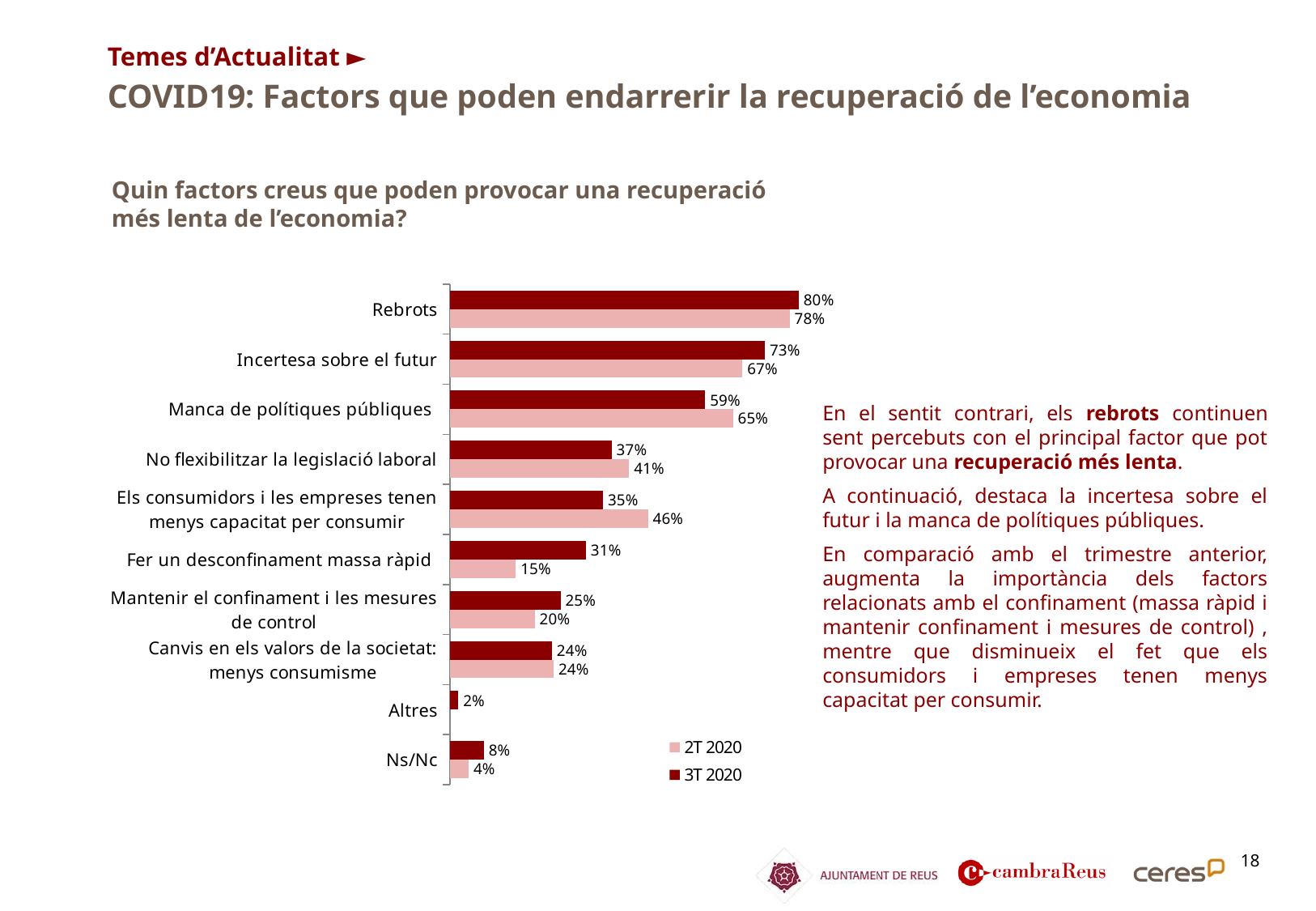
What is the value for Rebrots in the 3T 2020 series? 80% For Manca de polítiques públiques, which series has the larger value, 2T 2020 or 3T 2020? 2T 2020 What is the difference between the 3T 2020 and 2T 2020 values for Els consumidors i les empreses tenen menys capacitat per consumir? 11% What is the value for Ns/Nc in the 3T 2020 series? 8% How many categories are shown on the chart? 10 What is the value for Fer un desconfinament massa ràpid in the 2T 2020 series? 15% How many series does the legend list? 2 Which category has the highest value in the 3T 2020 series? Rebrots What kind of chart is shown on the slide? Bar chart What is the value for Incertesa sobre el futur in the 2T 2020 series? 67% Which category has the lowest value in the 3T 2020 series? Altres Which series is shown in dark red in the legend? 3T 2020